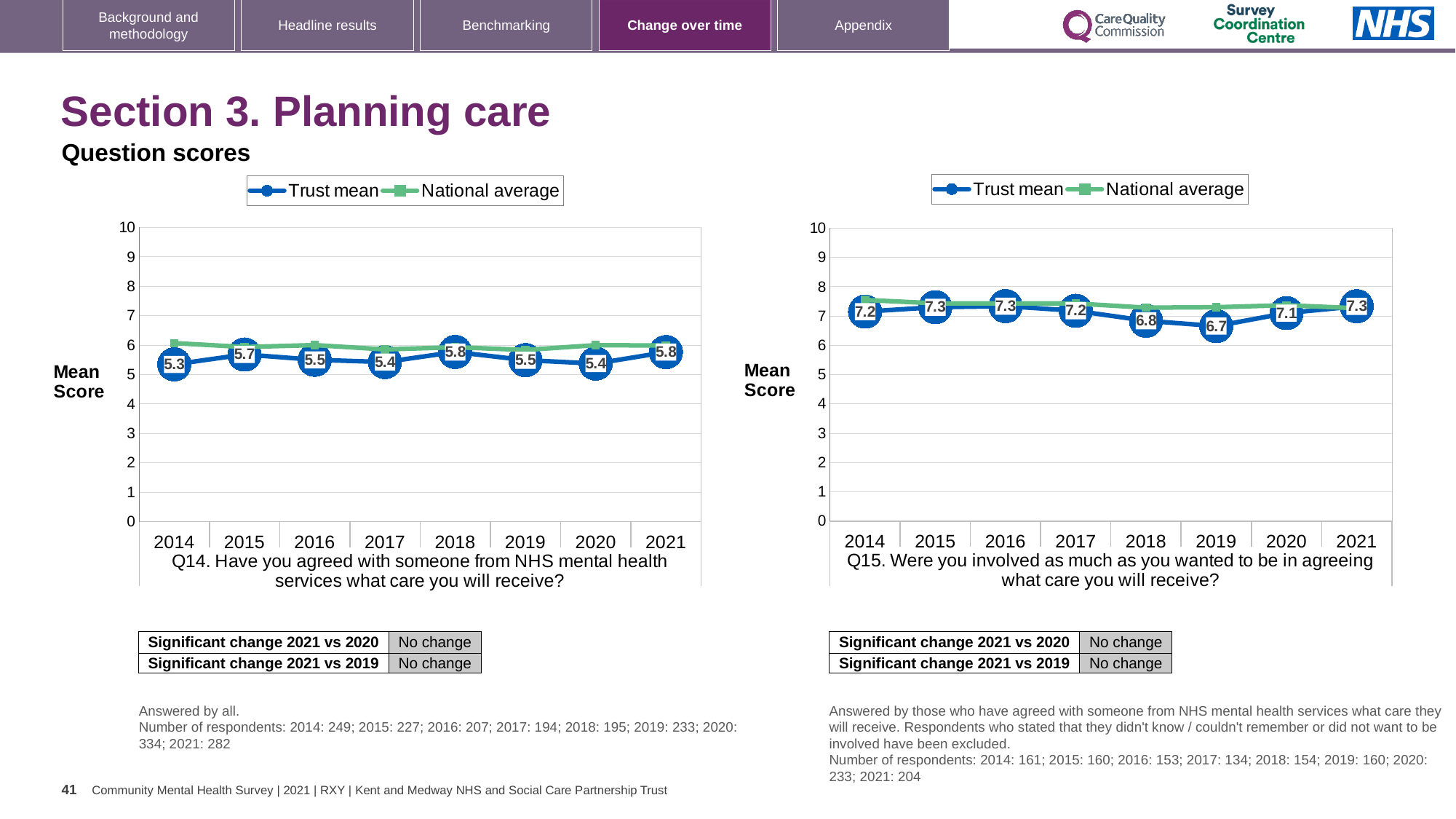
In the Q15 chart on the right, what is the Trust mean score for 2019? 6.7 In the Q14 chart on the left, which year has the lowest Trust mean score? 2014 In the Q15 chart on the right, is the National average for 2014 greater or less than 7? greater How many years are shown on the x axis of the Q14 chart on the left? 8 In the Q15 chart on the right, which year has the lowest Trust mean score? 2019 In the Q14 chart on the left, what is the Trust mean score for 2014? 5.3 In the Q14 chart on the left, what is the Trust mean score for 2018? 5.8 How many series does the legend of the Q15 chart on the right list? 2 In the Q15 chart on the right, what is the Trust mean score for 2021? 7.3 In the Q14 chart on the left, is the National average for 2014 greater or less than 7? less In the Q15 chart on the right, what is the difference between the Trust mean scores for 2021 and 2019? 0.6 In the Q14 chart on the left, which year has the higher Trust mean score, 2015 or 2017? 2015